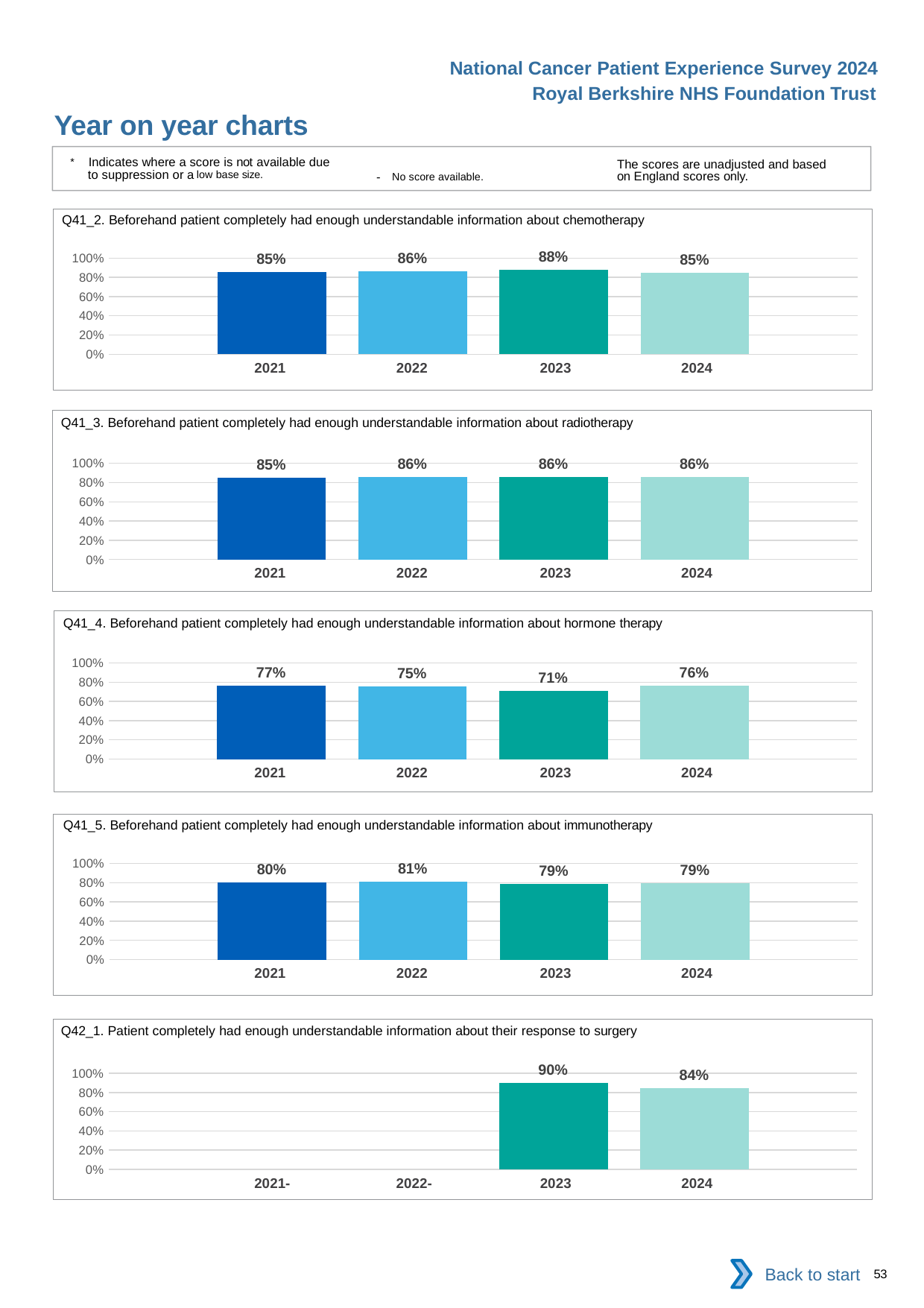
In the Q41_4 chart (hormone therapy), what is the difference between the 2021 and 2023 values? 6 percentage points In the Q41_5 chart (immunotherapy), is the value for 2021 greater or less than 2022? less In the Q41_2 chart (chemotherapy), what is the value for 2023? 88% In the Q41_4 chart (hormone therapy), which year has the lowest value? 2023 What type of chart is the Q41_3 chart (radiotherapy)? Bar chart In the Q42_1 chart (response to surgery), what is the value for 2024? 84% In the Q42_1 chart (response to surgery), how many years have a bar plotted? 2 How many charts are shown on the slide? 5 In the Q42_1 chart (response to surgery), what is the difference between the 2023 and 2024 values? 6 percentage points In the Q41_2 chart (chemotherapy), which year has the highest value? 2023 In the Q41_5 chart (immunotherapy), what is the value for 2022? 81% In the Q41_3 chart (radiotherapy), what is the value for 2021? 85%